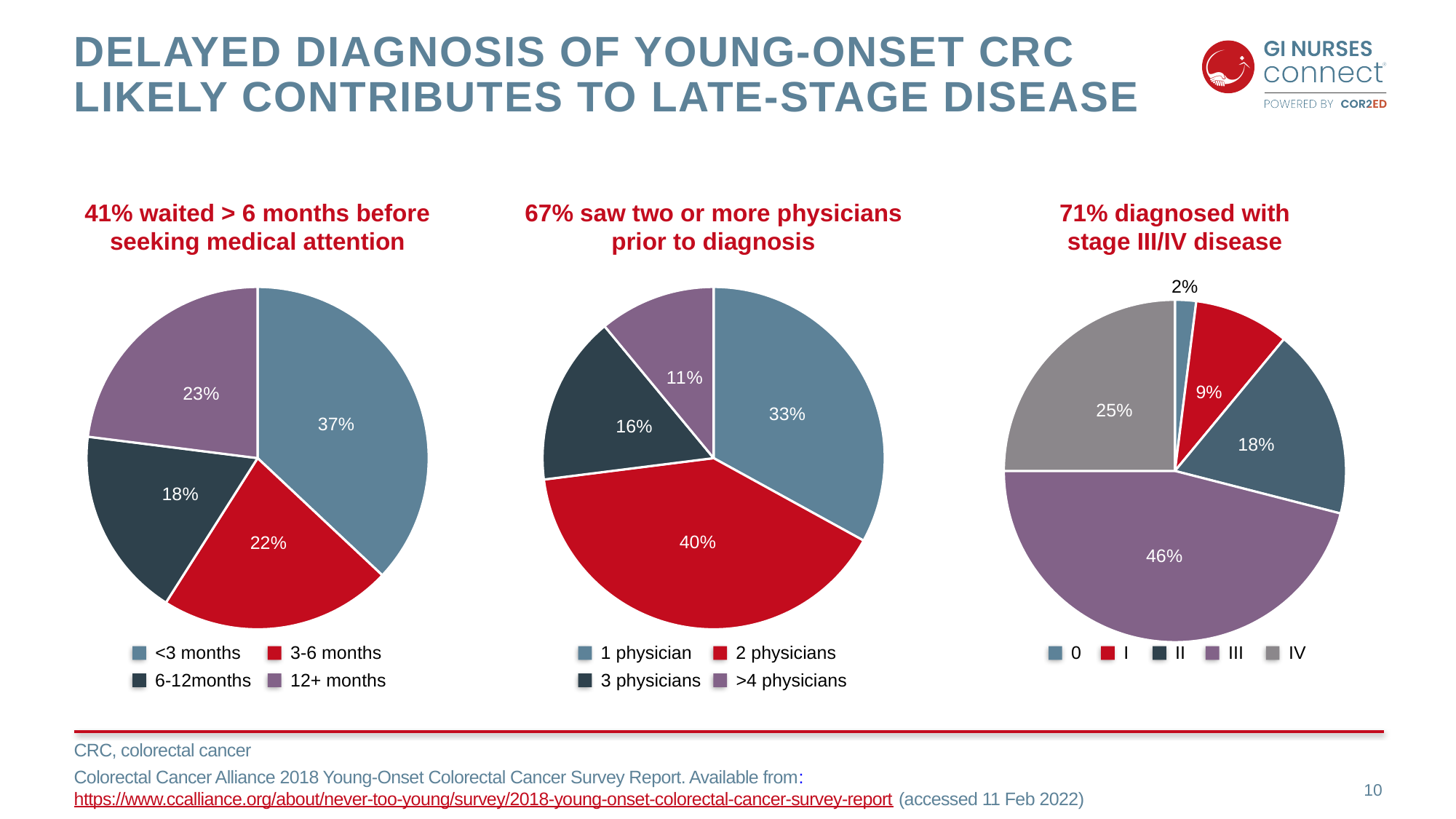
In the right chart (71% diagnosed with stage III/IV disease), how many categories does the legend list? 5 In the right chart (71% diagnosed with stage III/IV disease), which stage has the smallest slice? 0 In the middle chart (67% saw two or more physicians prior to diagnosis), what is the difference between the 1 physician and >4 physicians slices? 22% In the left chart (41% waited > 6 months before seeking medical attention), how many slices does the pie have? 4 In the right chart (71% diagnosed with stage III/IV disease), what percentage were diagnosed at stage III? 46% What type of chart is used for all three charts on the slide? Pie chart In the left chart (41% waited > 6 months before seeking medical attention), which category has the smallest slice? 6-12months In the left chart (41% waited > 6 months before seeking medical attention), what percentage waited <3 months? 37% In the left chart (41% waited > 6 months before seeking medical attention), what percentage waited 12+ months? 23% In the middle chart (67% saw two or more physicians prior to diagnosis), which is larger: 3 physicians or >4 physicians? 3 physicians In the middle chart (67% saw two or more physicians prior to diagnosis), what percentage saw 2 physicians? 40% In the middle chart (67% saw two or more physicians prior to diagnosis), which category has the largest slice? 2 physicians